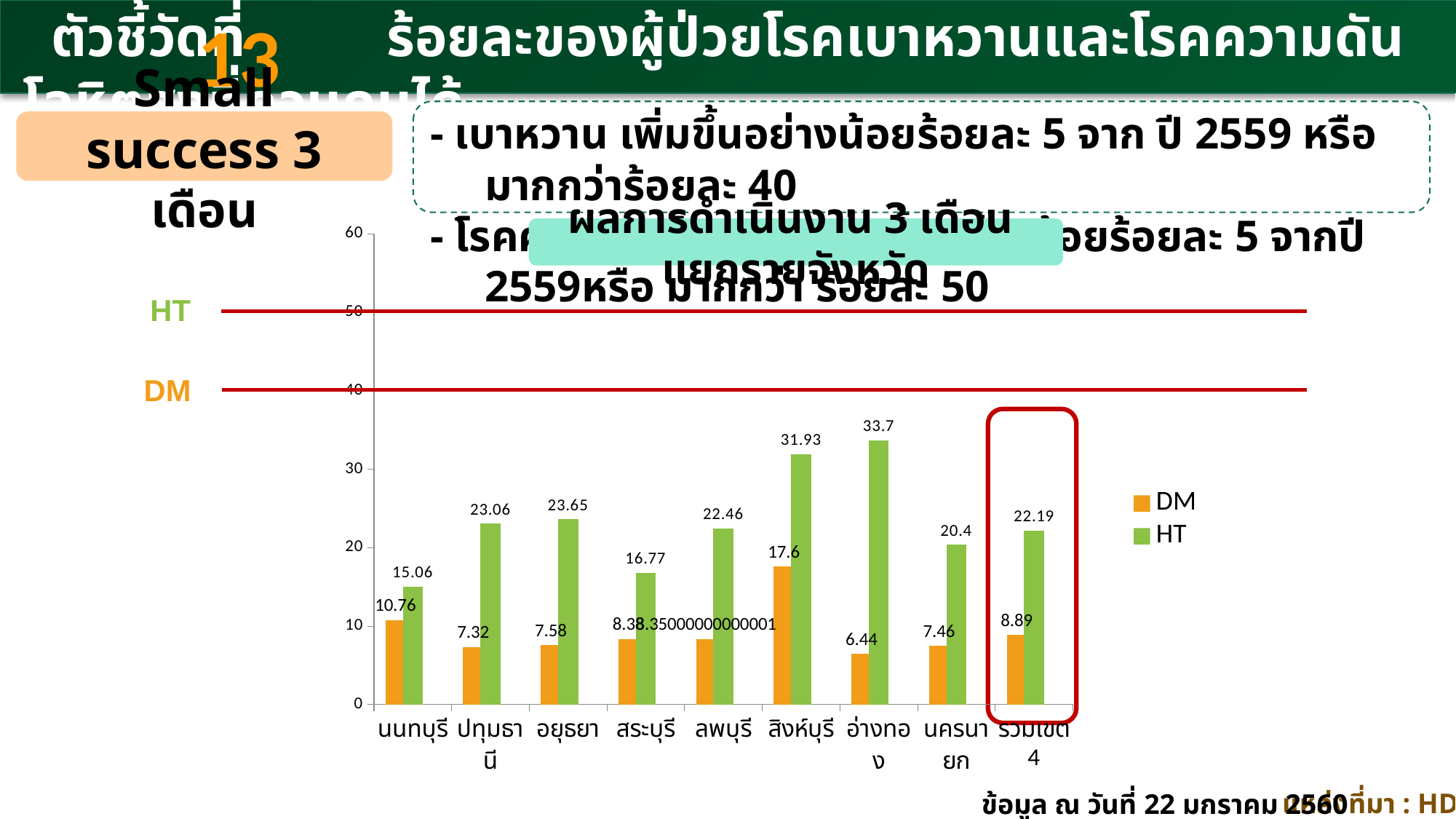
Which is larger, the HT value for ปทุมธานี or the HT value for อยุธยา? อยุธยา What is the HT value for อ่างทอง? 33.7 What is the difference between the HT and DM values for สิงห์บุรี? 14.33 What kind of chart is shown on the slide? bar chart What is the HT value for รวมเขต 4? 22.19 Which province has the lowest DM value? อ่างทอง What is the DM value for นนทบุรี? 10.76 What is the DM value for สิงห์บุรี? 17.6 How many series does the legend list? 2 Is the HT value for สิงห์บุรี greater or less than 30? greater How many categories are shown on the x axis? 9 Which province has the highest HT value? อ่างทอง